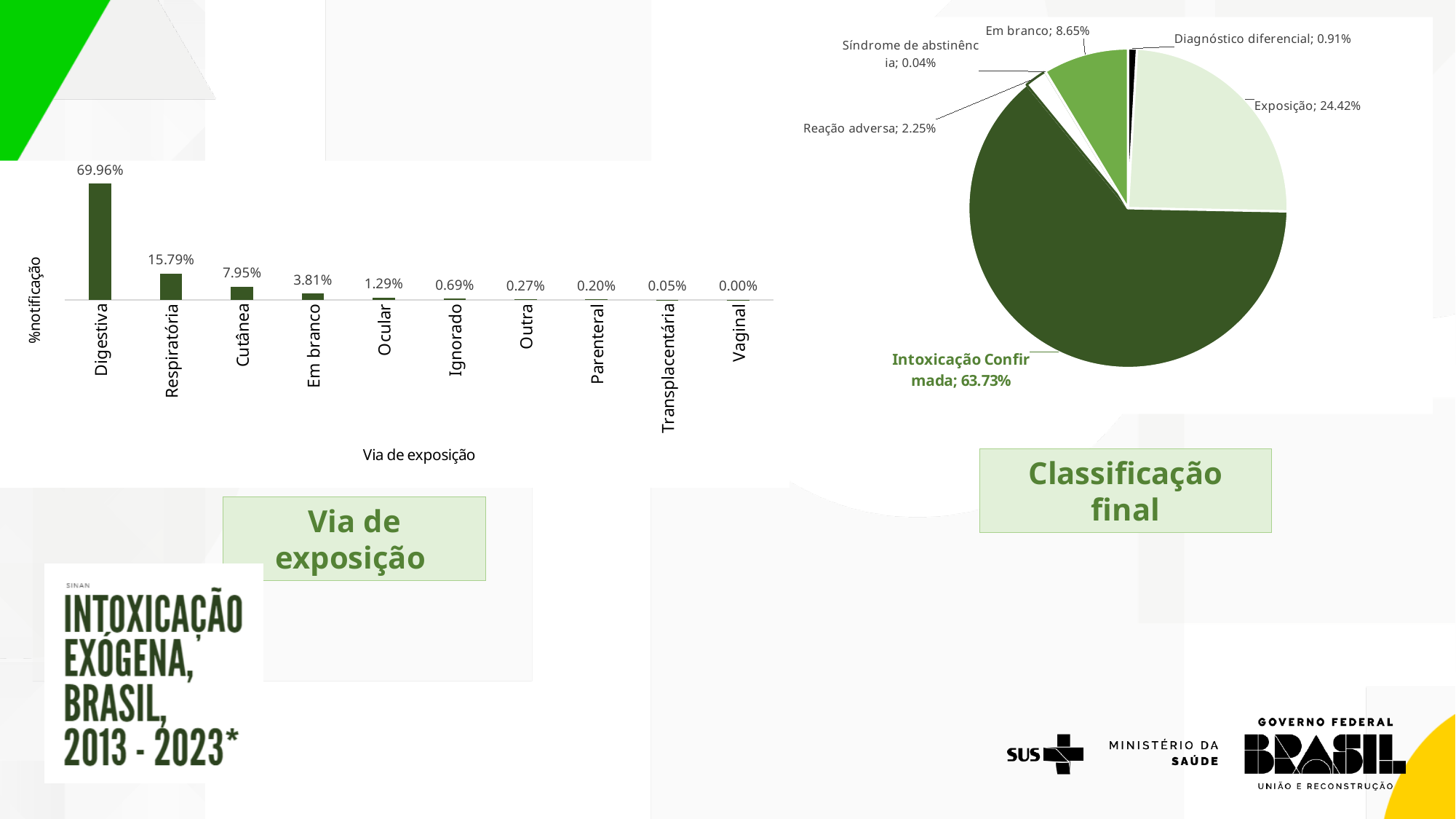
In the 'Via de exposição' bar chart, what is the value for Digestiva? 69.96% What kind of chart is the 'Via de exposição' chart? Bar chart In the 'Classificação final' pie chart, what is the share for Exposição? 24.42% In the 'Via de exposição' bar chart, what is the value for Respiratória? 15.79% In the 'Via de exposição' bar chart, which is larger, Cutânea or Em branco? Cutânea In the 'Classificação final' pie chart, which slice is the smallest? Síndrome de abstinência In the 'Via de exposição' bar chart, which category has the highest value? Digestiva In the 'Classificação final' pie chart, how many slices are labelled? 6 In the 'Classificação final' pie chart, which slice is the largest? Intoxicação Confirmada In the 'Via de exposição' bar chart, which category has the lowest value? Vaginal In the 'Via de exposição' bar chart, what is the difference between Digestiva and Respiratória? 54.17% In the 'Via de exposição' bar chart, how many categories are shown? 10